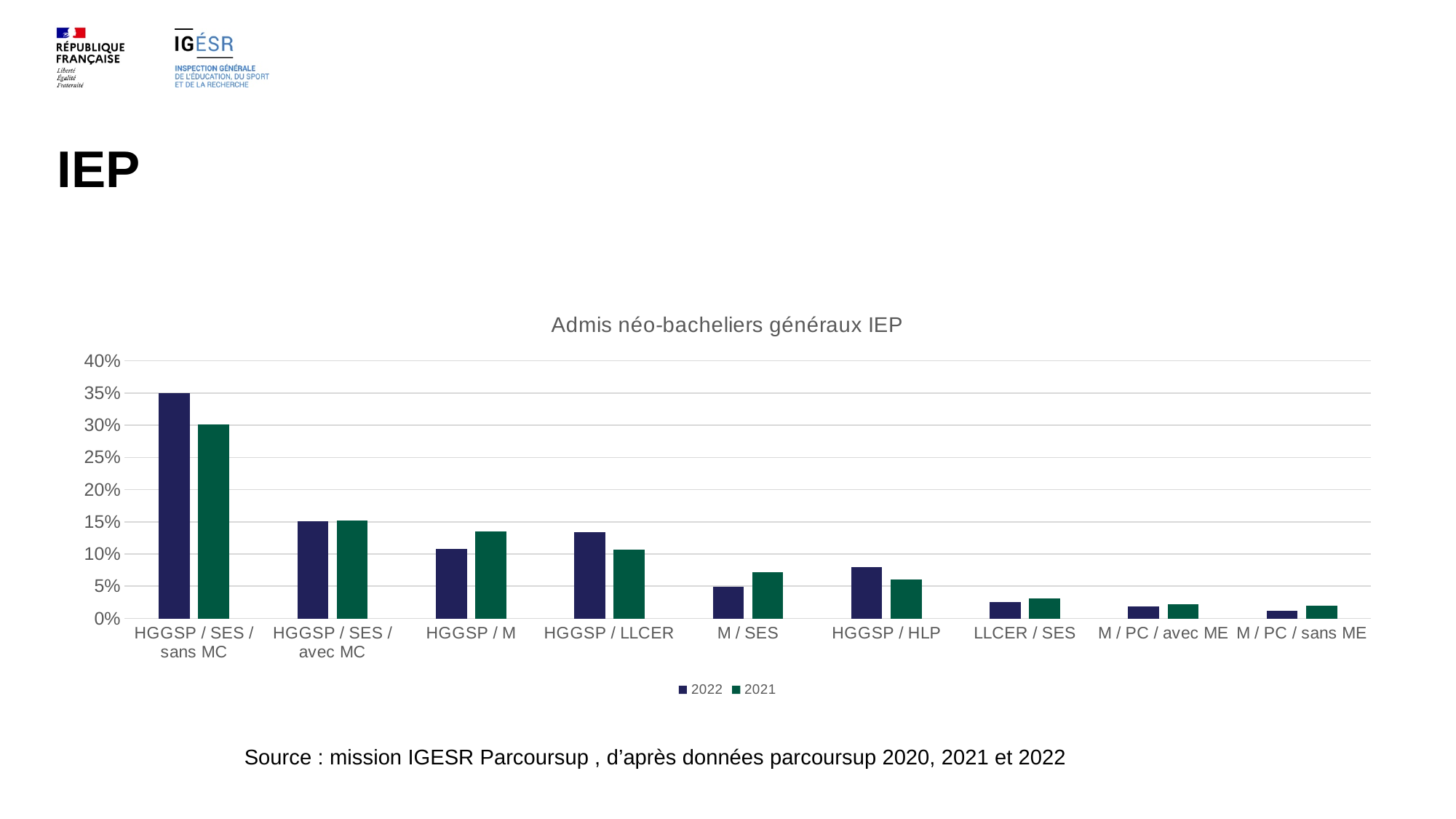
How many categories are shown on the x axis? 9 What kind of chart is shown on the slide? bar chart Which category has the lowest value for 2022? M / PC / sans ME For HGGSP / M, which year has the larger value, 2022 or 2021? 2021 How many series does the legend list? 2 Is the 2021 value for HGGSP / M greater or less than 10%? greater Is the 2022 value for HGGSP / SES / sans MC greater or less than 30%? greater Do the 2022 values generally rise or fall from left to right along the x axis? fall What is the title of the chart? Admis néo-bacheliers généraux IEP Is the 2022 value for HGGSP / HLP greater or less than 10%? less Which category has the highest value for 2022? HGGSP / SES / sans MC For HGGSP / LLCER, which year has the larger value, 2022 or 2021? 2022